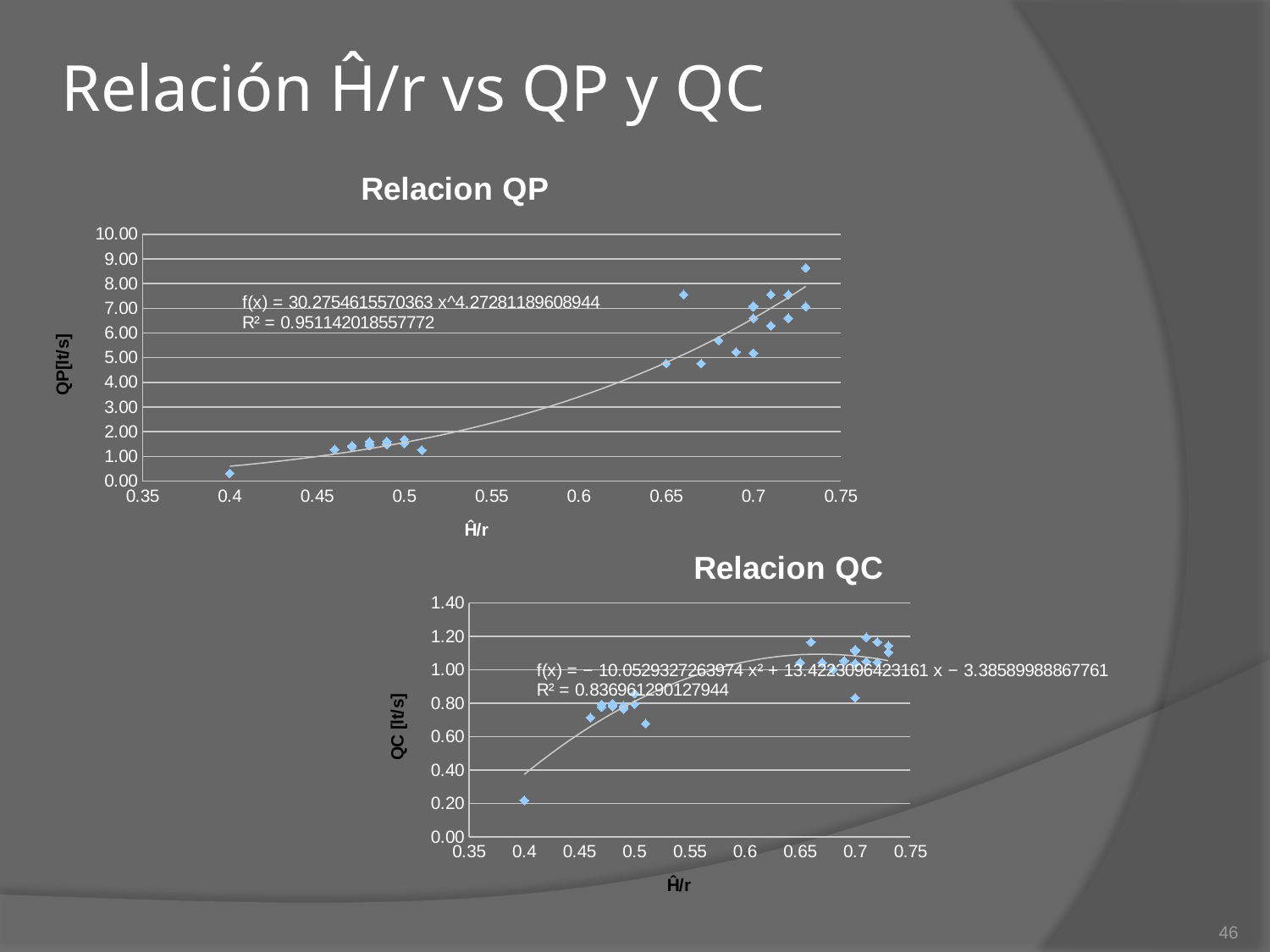
In the 'Relacion QP' chart, what is the R² value printed for the trendline? 0.951142018557772 In the 'Relacion QC' chart, what is the R² value printed for the trendline? 0.836961290127944 In the 'Relacion QP' chart, is the highest plotted point greater or less than 8.00? greater In the 'Relacion QC' chart, is the value at Ĥ/r = 0.4 greater or less than 0.40? less What kind of chart is the 'Relacion QP' chart? Scatter chart In the 'Relacion QC' chart, do the QC values generally rise or fall as Ĥ/r increases from 0.4 to 0.7? rise In the 'Relacion QP' chart, what is the trendline equation printed on the chart? f(x) = 30.2754615570363 x^4.27281189608944 What kind of chart is the 'Relacion QC' chart? Scatter chart What is the y-axis label of the 'Relacion QC' chart? QC [lt/s] In the 'Relacion QP' chart, is the value at Ĥ/r = 0.4 greater or less than 1.00? less What is the x-axis label shared by both charts? Ĥ/r In the 'Relacion QP' chart, do the QP values generally rise or fall as Ĥ/r increases? rise